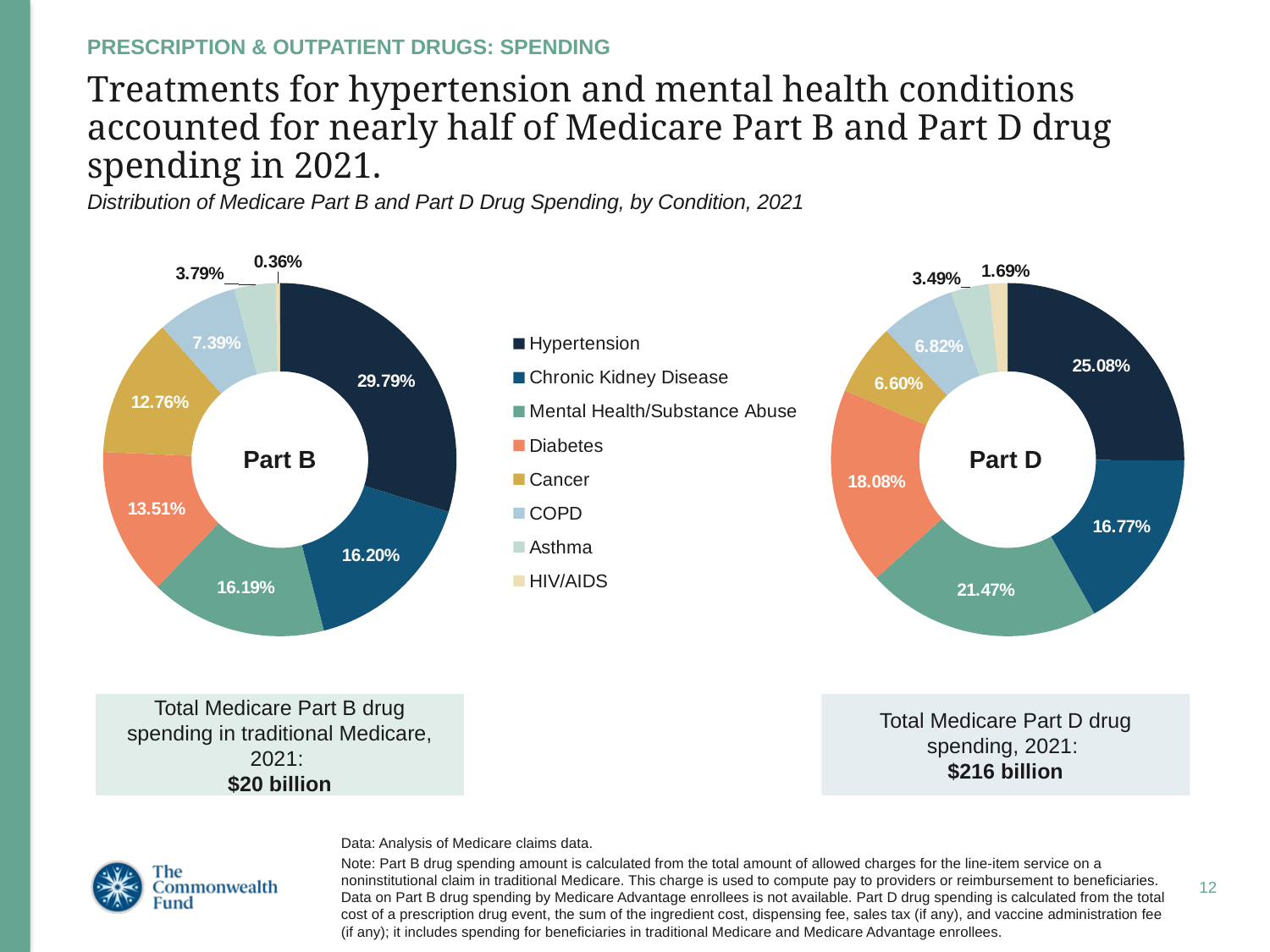
In the Part B chart, which is larger: the share for COPD or the share for Asthma? COPD In the Part D chart, which is larger: the share for Chronic Kidney Disease or the share for Diabetes? Diabetes In the Part D chart, what share of drug spending is for Diabetes? 18.08% In the Part D chart, what share of drug spending is for Mental Health/Substance Abuse? 21.47% What is the difference between the Hypertension share in the Part B chart and the Hypertension share in the Part D chart? 4.71 percentage points What kind of chart is used for the Part B chart? Pie chart (donut) In the Part B chart, which condition has the smallest share of drug spending? HIV/AIDS In the Part D chart, which condition has the largest share of drug spending? Hypertension What is the total Medicare Part D drug spending in 2021 shown on the slide? $216 billion In the Part B chart, what share of drug spending is for Cancer? 12.76% In the Part B chart, what share of drug spending is for Hypertension? 29.79% How many conditions does the legend list? 8